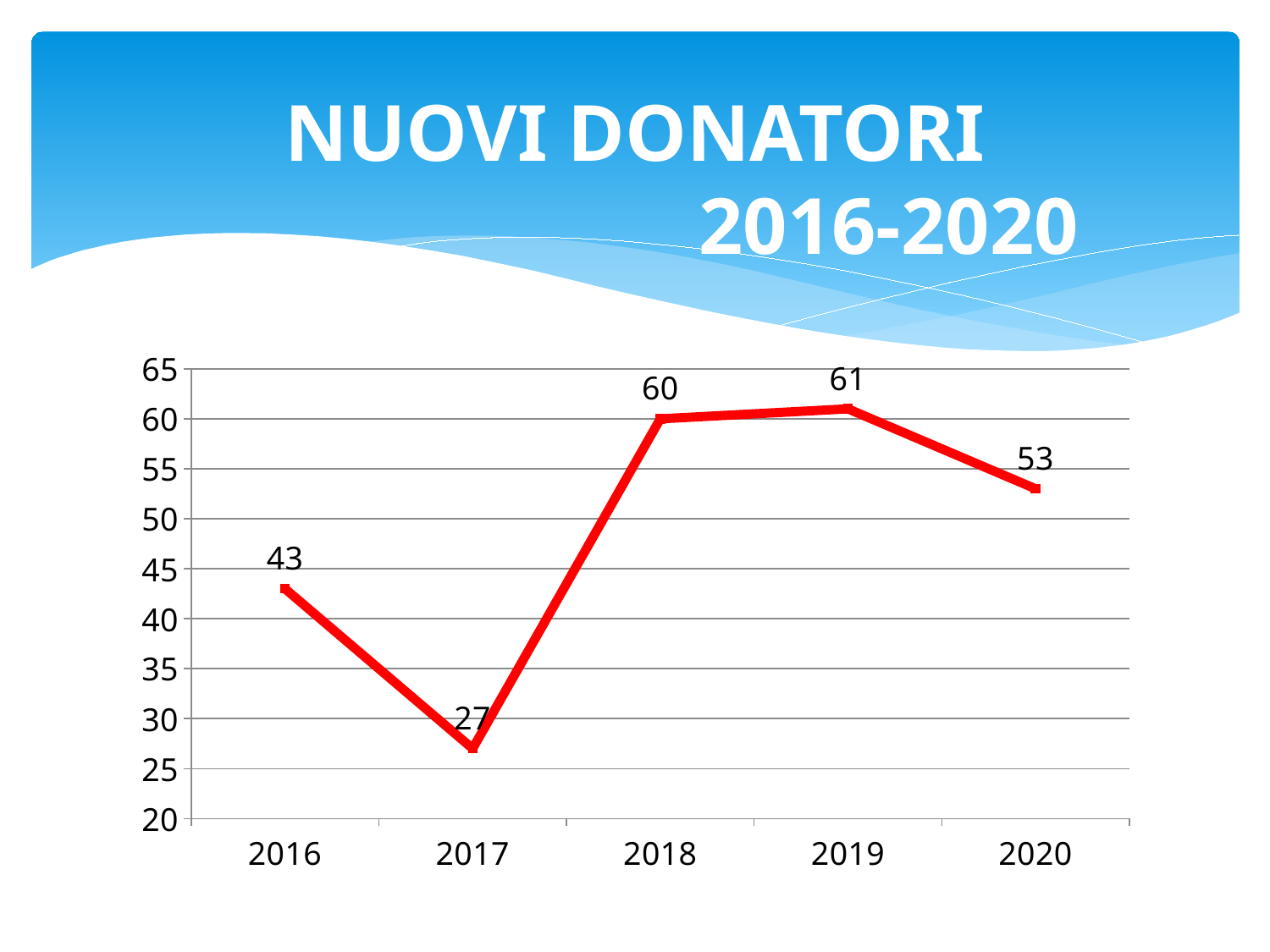
What is the value for 2016? 43 Is the value for 2017 greater or less than 30? less What kind of chart is shown on the slide? line chart How many years are plotted on the chart? 5 What is the value for 2017? 27 Which is larger, the value for 2016 or the value for 2020? 2020 Which year has the highest value? 2019 Which year has the lowest value? 2017 Does the value rise or fall from 2017 to 2018? rise What is the difference between the values for 2019 and 2020? 8 What is the value for 2020? 53 What is the difference between the values for 2018 and 2017? 33